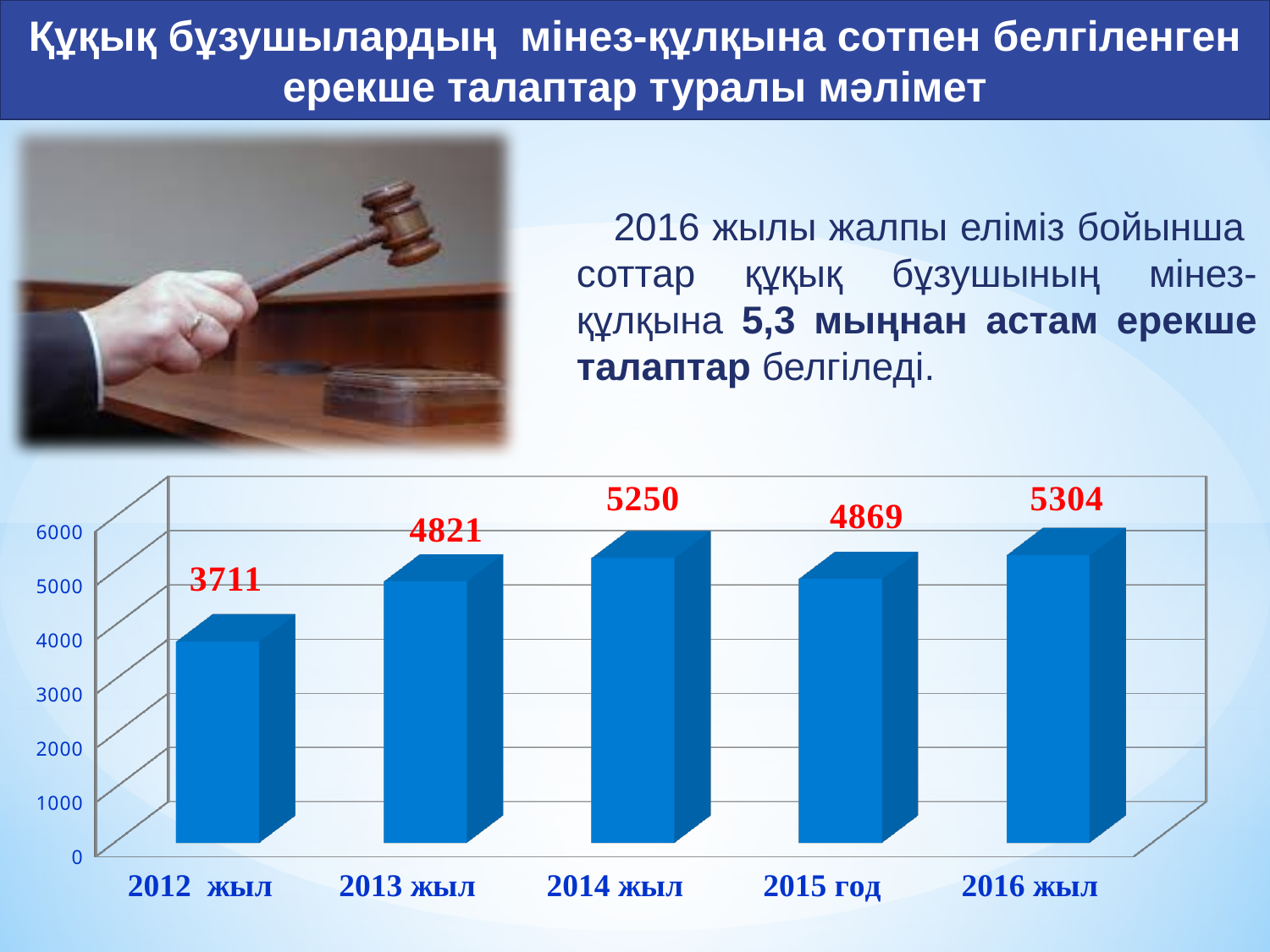
What is the value for 2012 жыл? 3711 Which is larger, the value for 2014 жыл or the value for 2015 год? 2014 жыл What is the value for 2014 жыл? 5250 What kind of chart is shown on the slide? bar chart What is the value for 2015 год? 4869 How many years are shown on the chart? 5 What is the difference between the values for 2014 жыл and 2013 жыл? 429 What colour are the bars in the chart? blue Which year has the lowest value? 2012 жыл Which year has the highest value? 2016 жыл What is the difference between the values for 2016 жыл and 2012 жыл? 1593 Is the value for 2012 жыл greater or less than 4000? less